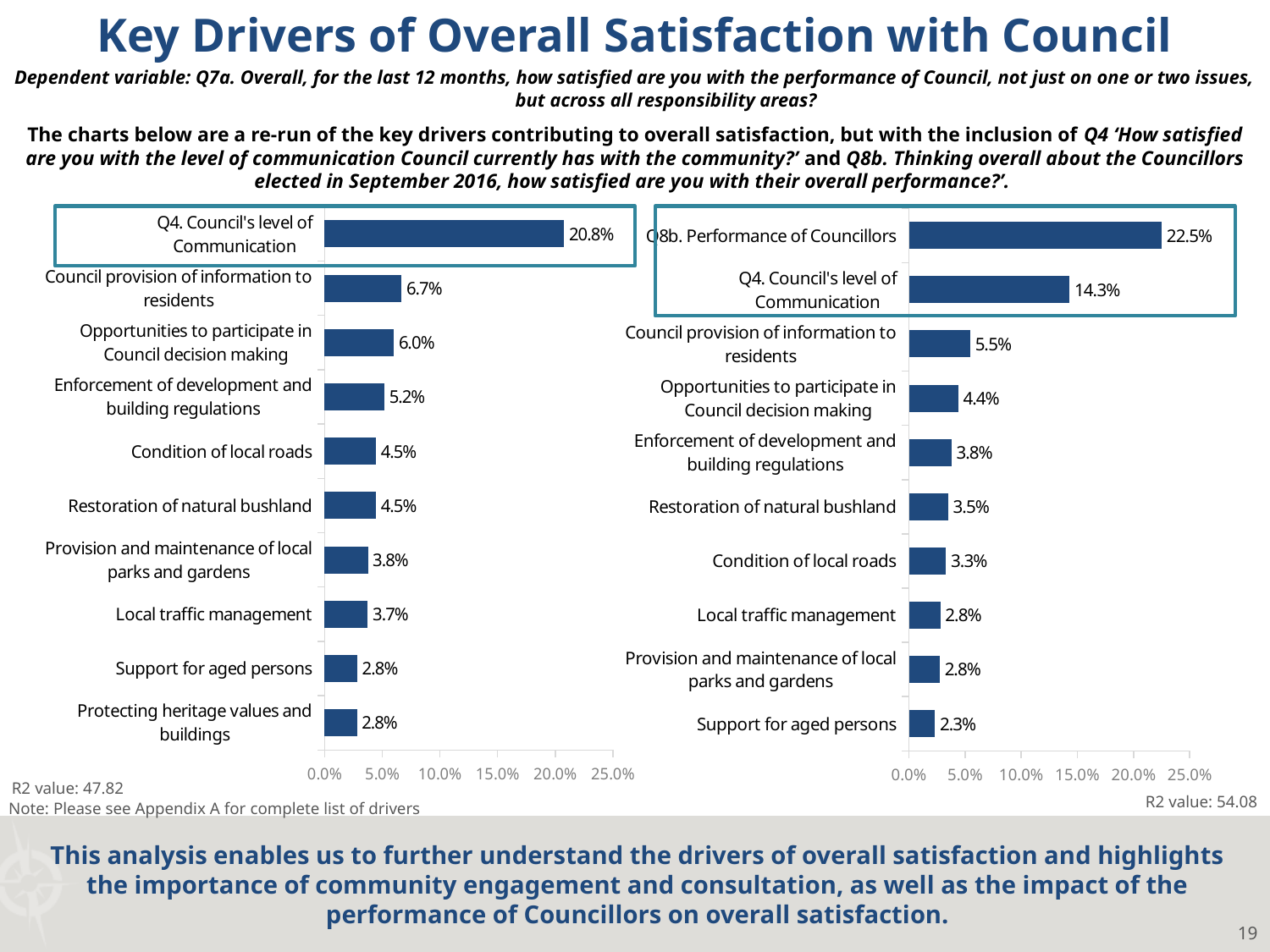
In the right chart, what is the value for Q4. Council's level of Communication? 14.3% What type of chart is the right chart? Bar chart In the left chart, what is the difference between Q4. Council's level of Communication and Council provision of information to residents? 14.1% In the right chart, what is the value for Q8b. Performance of Councillors? 22.5% In the left chart, which category has the highest value? Q4. Council's level of Communication In the left chart, which is larger: Enforcement of development and building regulations or Local traffic management? Enforcement of development and building regulations How many categories are shown in the right chart? 10 In the left chart, what is the value for Council provision of information to residents? 6.7% In the right chart, which category has the lowest value? Support for aged persons How many categories are shown in the left chart? 10 In the right chart, what is the difference between Q8b. Performance of Councillors and Q4. Council's level of Communication? 8.2% In the left chart, what is the value for Condition of local roads? 4.5%